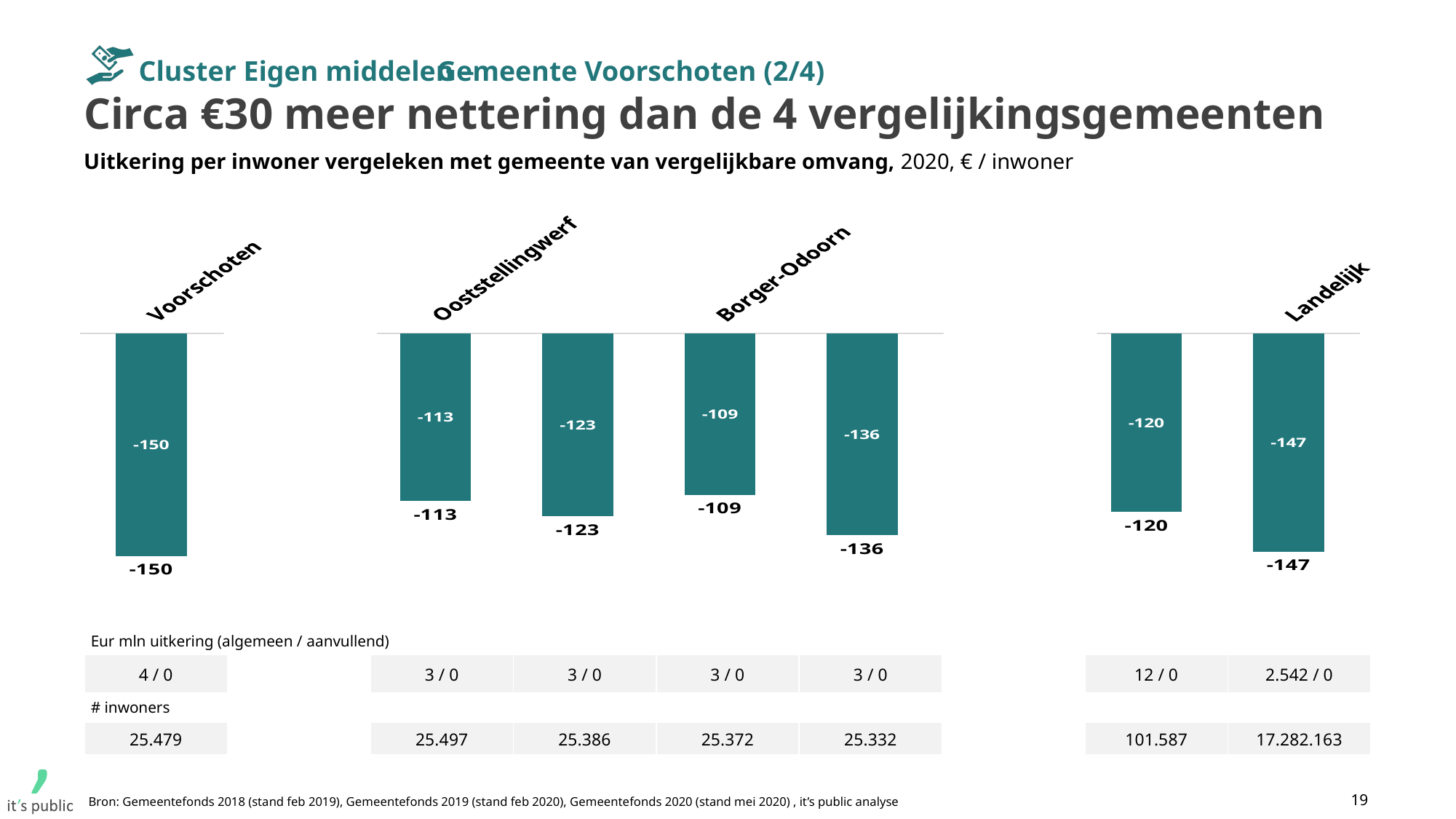
What kind of chart is shown on the slide? Bar chart What is the value for Voorschoten? -150 What is the value for Ooststellingwerf? -113 How many bars are plotted in the chart? 7 Which category has the lowest (most negative) value? Voorschoten What is the value for Landelijk? -147 Which category has the highest (least negative) value? Borger-Odoorn What is the difference between the values for Voorschoten and Ooststellingwerf? 37 Which has the lower value, Voorschoten or Borger-Odoorn? Voorschoten What is the difference between the values for Voorschoten and Landelijk? 3 In what unit are the chart values expressed, according to the subtitle? € / inwoner What is the value for Borger-Odoorn? -109